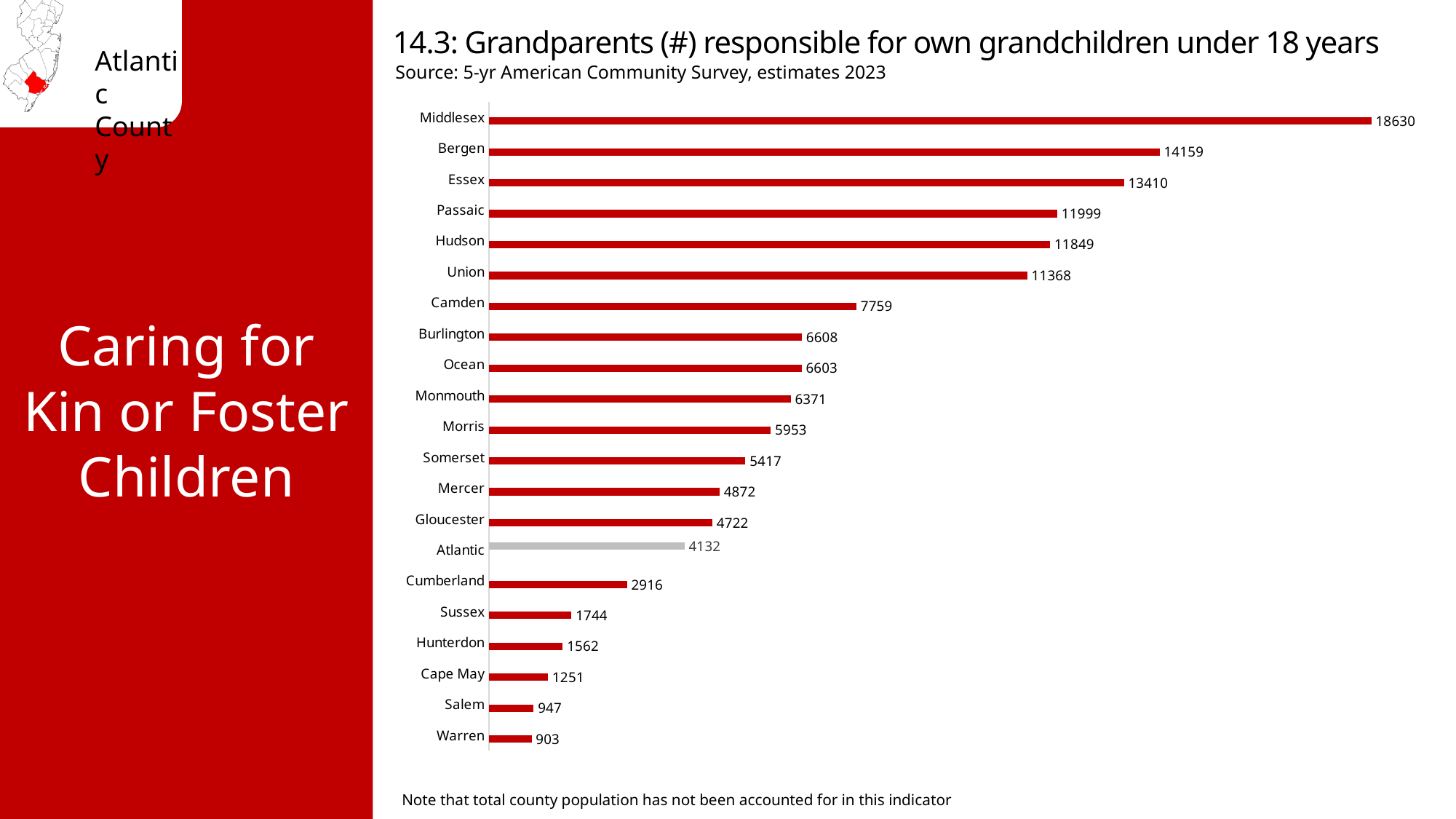
What is the value for Atlantic? 4132 Which is larger, the value for Passaic or the value for Union? Passaic Which is larger, the value for Mercer or the value for Gloucester? Mercer What kind of chart is shown on the slide? Bar chart How many counties are shown in the chart? 21 What is the difference between the values for Atlantic and Cumberland? 1216 Which county has the lowest value? Warren What is the value for Cape May? 1251 Which county has the highest value? Middlesex Which county's bar is coloured grey instead of red? Atlantic What is the value for Camden? 7759 What is the difference between the values for Middlesex and Bergen? 4471